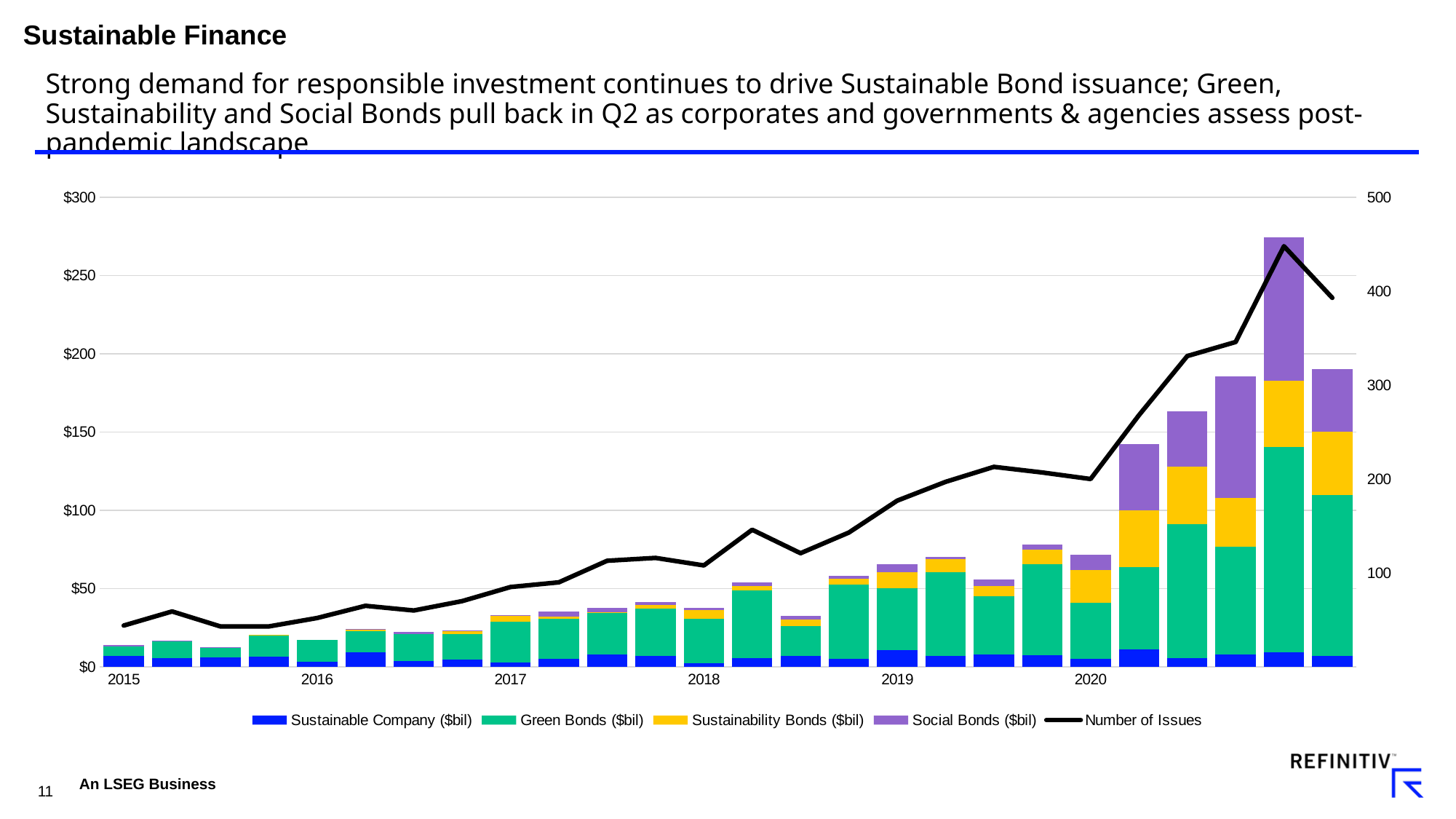
Does the Number of Issues line generally rise or fall from 2015 to the end of the chart? rise Is the total of the first stacked bar (2015) greater or less than $50? less How many series does the legend list? 5 What is the highest value shown on the left-hand y axis? $300 How many stacked bars are plotted in the chart? 26 What kind of chart is shown on the slide? Stacked bar chart with a line Which series is plotted as a black line? Number of Issues Is the total of the stacked bar at the 2020 x-axis label greater or less than $100? less Is the Number of Issues at the 2015 x-axis label greater or less than 100? less Which colour represents Green Bonds ($bil) in the legend? Green